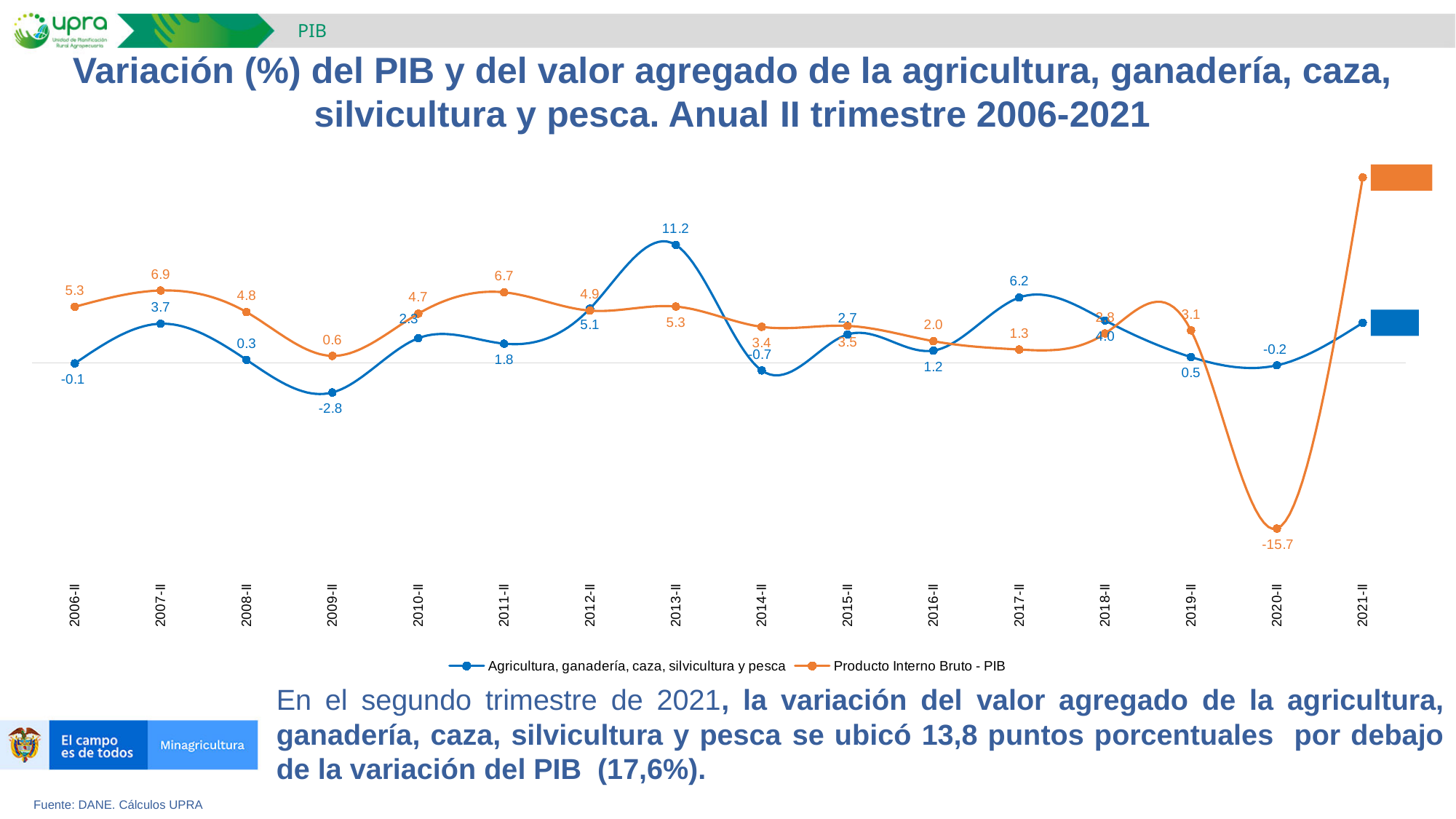
How many periods are plotted along the x axis? 16 How many series does the legend list? 2 In which period does Agricultura, ganadería, caza, silvicultura y pesca reach its highest value? 2013-II What is the value for Agricultura, ganadería, caza, silvicultura y pesca in 2009-II? -2.8 What is the difference between the Agricultura series and the PIB series in 2013-II? 5.9 Which series is drawn in orange? Producto Interno Bruto - PIB In 2009-II, which series has the higher value, Agricultura or PIB? Producto Interno Bruto - PIB What is the value for Producto Interno Bruto - PIB in 2020-II? -15.7 What type of chart is shown on the slide? line chart What is the value for Agricultura, ganadería, caza, silvicultura y pesca in 2013-II? 11.2 What is the value for Producto Interno Bruto - PIB in 2007-II? 6.9 In which period does Producto Interno Bruto - PIB reach its lowest value? 2020-II